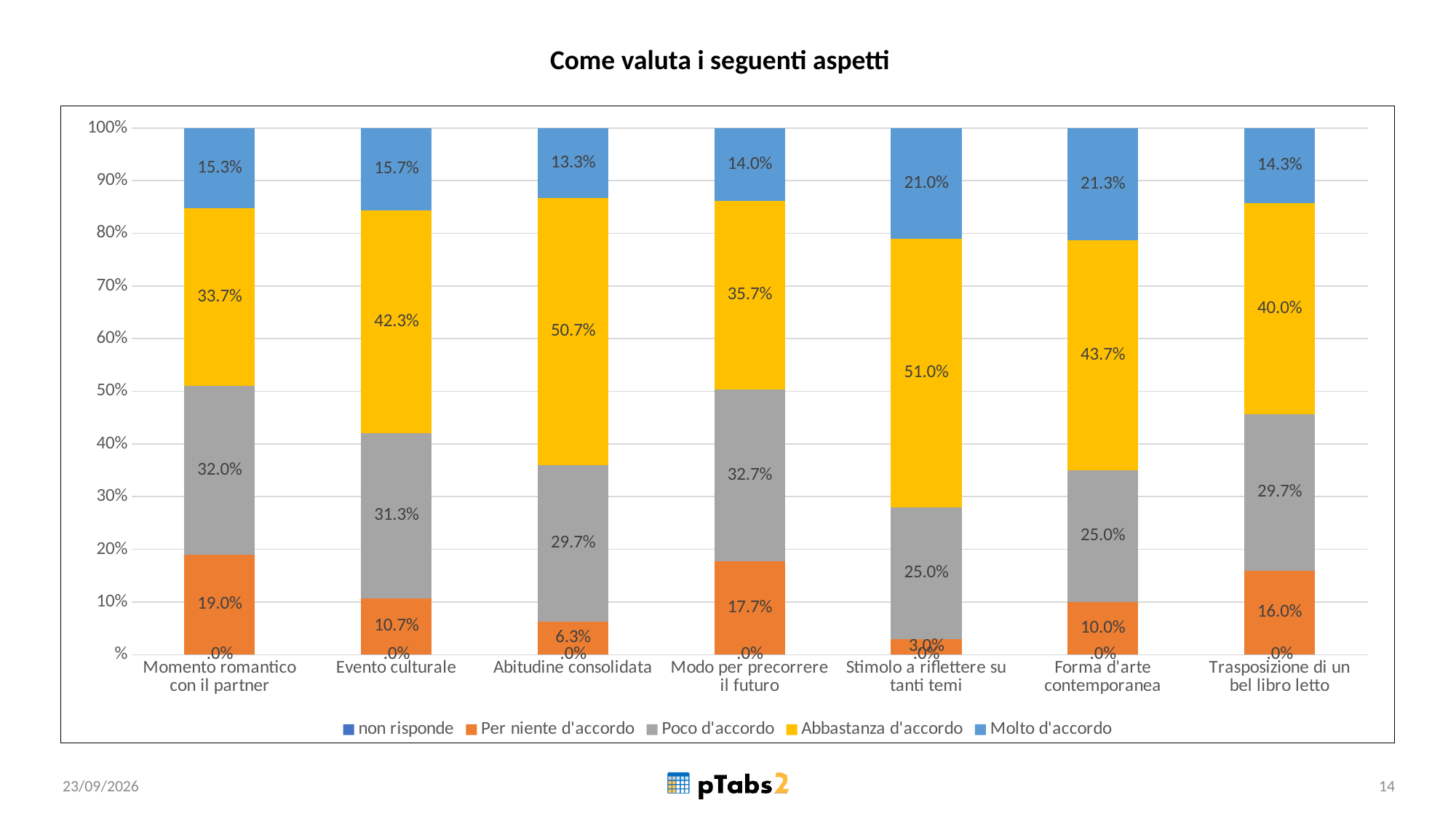
What is the 'Abbastanza d'accordo' value for 'Abitudine consolidata'? 50.7% What is the 'Molto d'accordo' value for 'Forma d'arte contemporanea'? 21.3% Which category has the lowest 'Per niente d'accordo' value? Stimolo a riflettere su tanti temi What is the title of the chart? Come valuta i seguenti aspetti What is the 'Poco d'accordo' value for 'Evento culturale'? 31.3% How many series does the legend list? 5 What is the difference between the 'Poco d'accordo' and 'Per niente d'accordo' values for 'Momento romantico con il partner'? 13.0 percentage points Which is larger: the 'Abbastanza d'accordo' value for 'Evento culturale' or for 'Modo per precorrere il futuro'? Evento culturale What is the 'Per niente d'accordo' value for 'Trasposizione di un bel libro letto'? 16.0% Which category has the highest 'Per niente d'accordo' value? Momento romantico con il partner What type of chart is shown on the slide? Stacked bar chart How many categories are shown on the x axis of the chart? 7